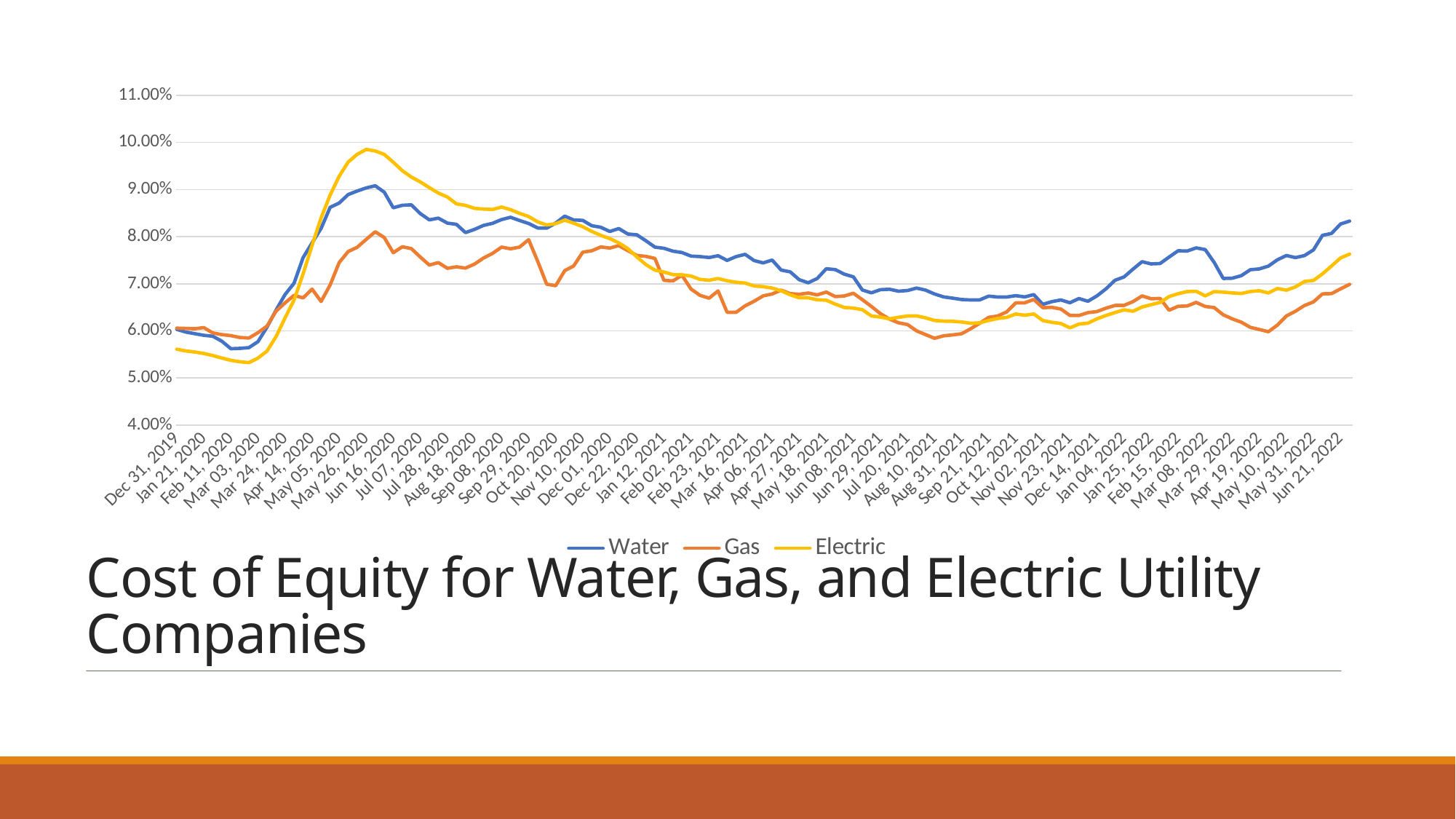
Is the peak value of the Electric series around Jun 16, 2020 greater or less than 9.00%? greater At Jun 16, 2020, which series is higher, Water or Electric? Electric At Aug 31, 2021, which series is higher, Water or Gas? Water How many series does the legend list? 3 What is the title of the chart on the slide? Cost of Equity for Water, Gas, and Electric Utility Companies Which series reaches the highest value anywhere on the chart? Electric Is the value for Electric at Dec 31, 2019 greater or less than 6.00%? less Does the Water series rise or fall between Aug 31, 2021 and Jun 21, 2022? Rise Which series reaches the lowest value anywhere on the chart? Electric Is the value for Water at Jun 21, 2022 greater or less than 8.00%? greater What kind of chart is shown on the slide? Line chart